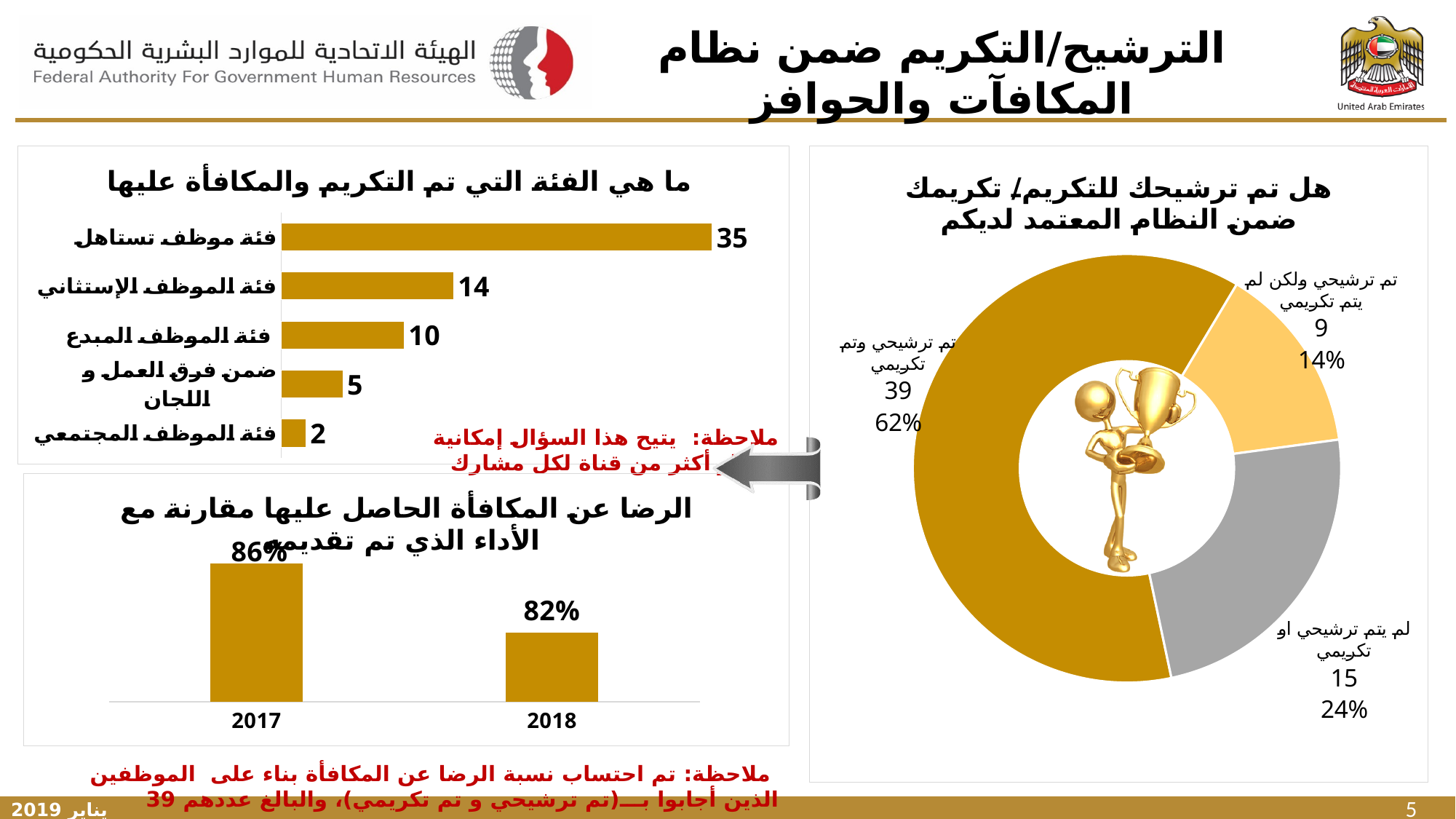
In the top-left bar chart (ما هي الفئة التي تم التكريم والمكافأة عليها), what is the value for فئة موظف تستاهل? 35 In the top-left bar chart (ما هي الفئة التي تم التكريم والمكافأة عليها), how many categories are shown? 5 In the bottom-left bar chart (الرضا عن المكافأة الحاصل عليها مقارنة مع الأداء الذي تم تقديمه), does the value rise or fall from 2017 to 2018? Fall In the top-left bar chart (ما هي الفئة التي تم التكريم والمكافأة عليها), which category has the lowest value? فئة الموظف المجتمعي In the right-hand donut chart (هل تم ترشيحك للتكريم/ تكريمك ضمن النظام المعتمد لديكم), what is the count for لم يتم ترشيحي او تكريمي? 15 What kind of chart is the top-left chart (ما هي الفئة التي تم التكريم والمكافأة عليها)? Bar chart In the bottom-left bar chart (الرضا عن المكافأة الحاصل عليها مقارنة مع الأداء الذي تم تقديمه), what is the value for 2018? 82% In the top-left bar chart (ما هي الفئة التي تم التكريم والمكافأة عليها), what is the difference between فئة الموظف الإستثنائي and فئة الموظف المبدع? 4 In the right-hand donut chart (هل تم ترشيحك للتكريم/ تكريمك ضمن النظام المعتمد لديكم), what share does تم ترشيحي وتم تكريمي represent? 62% In the bottom-left bar chart (الرضا عن المكافأة الحاصل عليها مقارنة مع الأداء الذي تم تقديمه), what is the difference between 2017 and 2018? 4% In the right-hand donut chart (هل تم ترشيحك للتكريم/ تكريمك ضمن النظام المعتمد لديكم), which segment is the smallest? تم ترشيحي ولكن لم يتم تكريمي In the top-left bar chart (ما هي الفئة التي تم التكريم والمكافأة عليها), which is larger: ضمن فرق العمل و اللجان or فئة الموظف المبدع? فئة الموظف المبدع